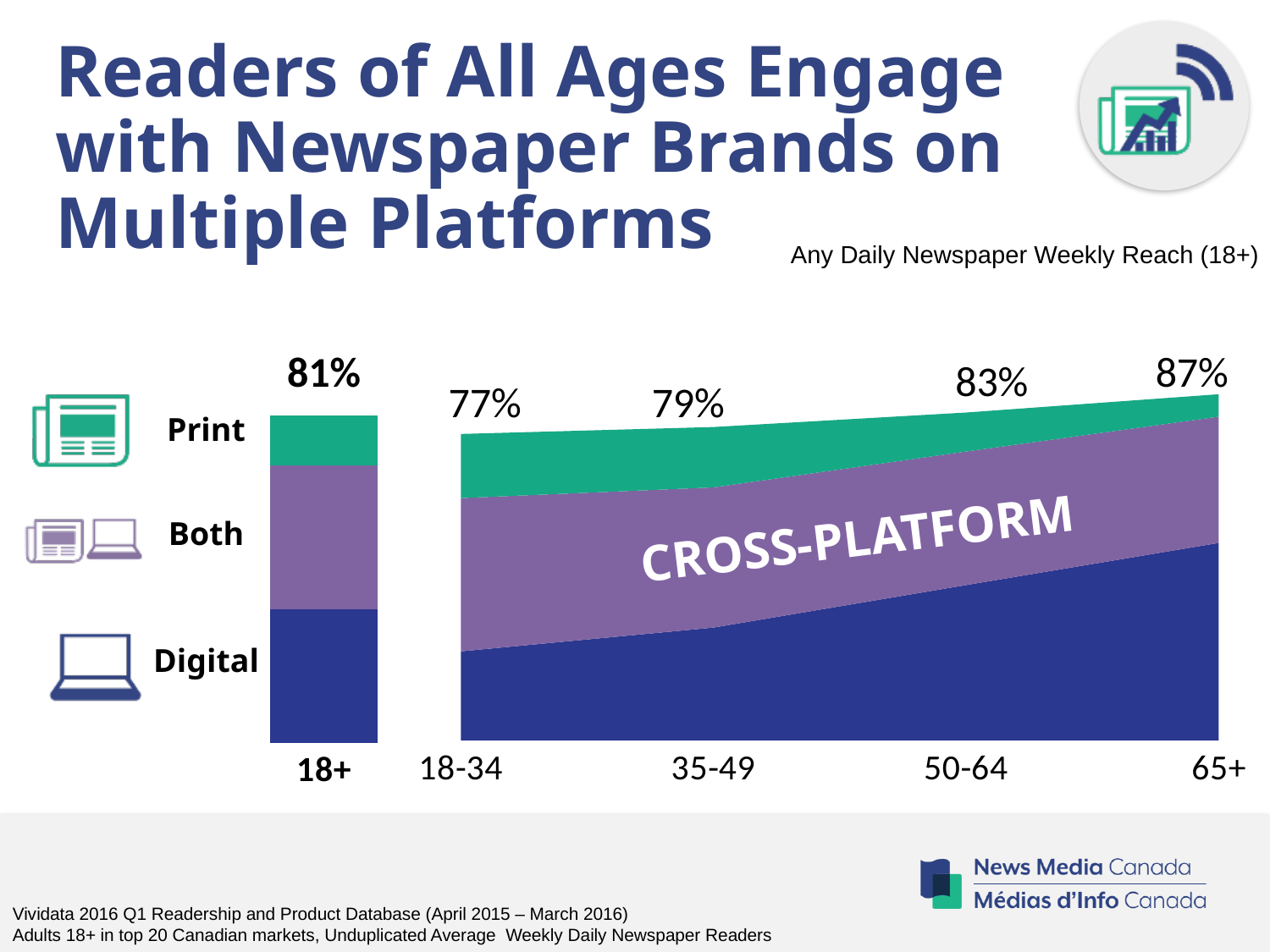
In the right area chart, which age group has the highest weekly reach? 65+ In the right area chart, how much higher is the weekly reach for 65+ than for 18-34? 10 percentage points What label is printed across the middle (Both) band of the right area chart? CROSS-PLATFORM In the right area chart, what is the weekly reach for the 50-64 age group? 83% How many age groups are shown along the x axis of the right area chart? 4 In the right area chart, what is the weekly reach for the 18-34 age group? 77% In the right area chart, which age group has the lowest weekly reach? 18-34 How many platform categories (series) are listed in the legend on the left? 3 In the right area chart, which has the larger weekly reach, 35-49 or 50-64? 50-64 In the right area chart, does weekly reach rise or fall as the age groups get older? rise In the left stacked bar chart, what is the total weekly reach shown for the 18+ group? 81% In the right area chart, what is the weekly reach for the 65+ age group? 87%